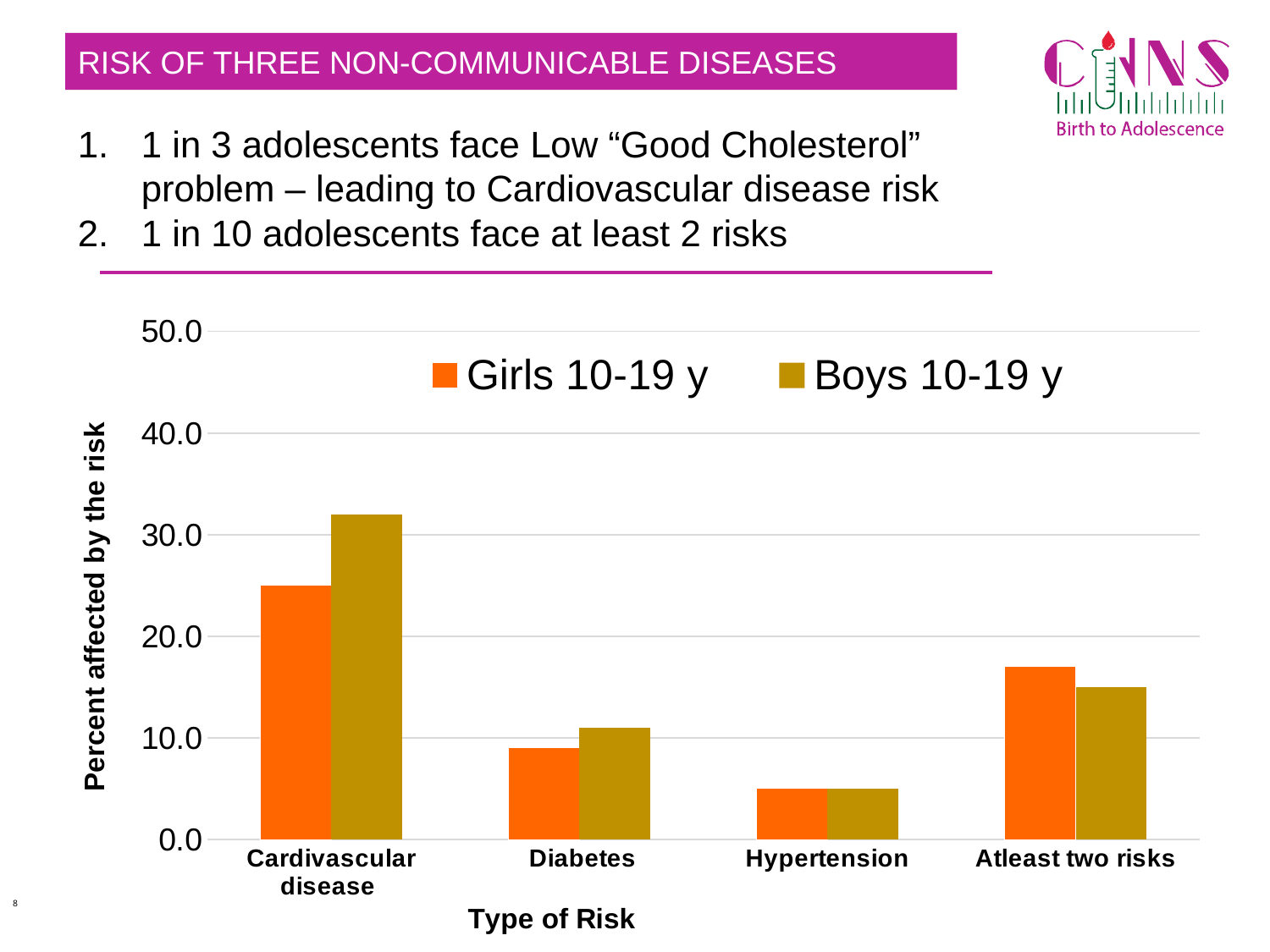
Which type of risk has the lowest value for Girls 10-19 y? Hypertension For Cardivascular disease, which series has the larger value, Girls 10-19 y or Boys 10-19 y? Boys 10-19 y Which type of risk has the highest value for Boys 10-19 y? Cardivascular disease Is the value for Girls 10-19 y for Cardivascular disease greater or less than 30.0? less How many series does the legend list? 2 How many types of risk are shown on the x axis? 4 Is the value for Boys 10-19 y for Hypertension greater or less than 10.0? less Is the value for Boys 10-19 y for Cardivascular disease greater or less than 30.0? greater For Atleast two risks, which series has the larger value, Girls 10-19 y or Boys 10-19 y? Girls 10-19 y What is the label of the y axis? Percent affected by the risk What kind of chart is shown on the slide? bar chart